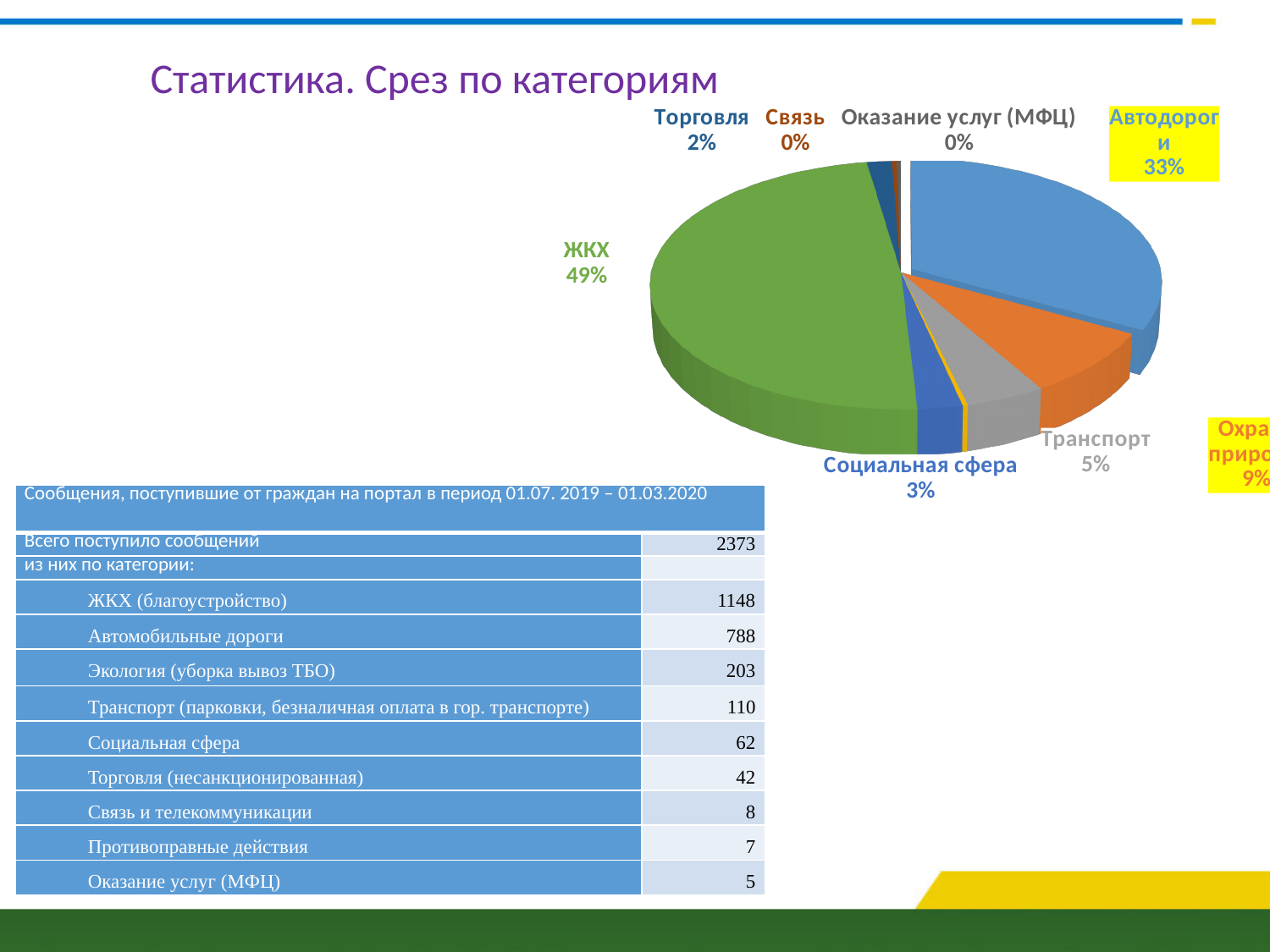
What is the value shown for Связь? 0% By how many percentage points does ЖКХ exceed Автодороги? 16% What is the value shown for Автодороги? 33% What share of the pie does ЖКХ take? 49% What is the value shown for Транспорт? 5% What is the value shown for Торговля? 2% What is the title of the slide containing the pie chart? Статистика. Срез по категориям What colour is the ЖКХ slice of the pie? green Which category has the largest slice of the pie? ЖКХ What kind of chart is shown on the slide? pie chart Which is larger, the slice for Автодороги or the slice for Транспорт? Автодороги What is the value shown for Социальная сфера? 3%